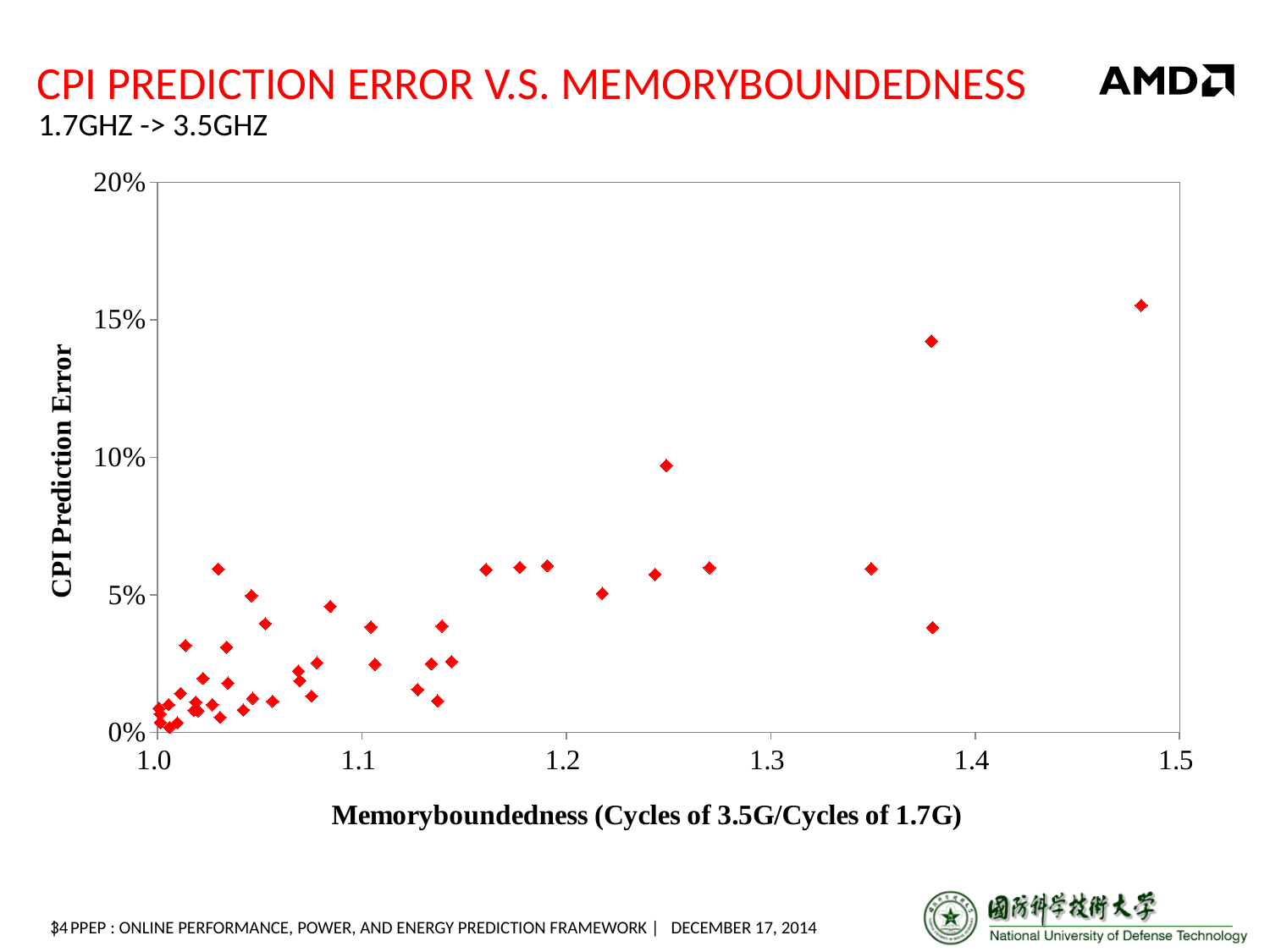
What kind of chart is shown on the slide? scatter chart What range does the y axis cover? 0% to 20% Are the points with memoryboundedness below 1.1 all greater or less than 10% CPI prediction error? less Is the CPI prediction error of the highest point near memoryboundedness 1.38 greater or less than 10%? greater As memoryboundedness increases along the x axis, does the CPI prediction error generally rise or fall? rise Which has the higher CPI prediction error: the rightmost point (near memoryboundedness 1.48) or the highest point near memoryboundedness 1.25? the rightmost point (near 1.48) Is the highest CPI prediction error plotted on the chart greater or less than 20%? less What is the title of the x axis? Memoryboundedness (Cycles of 3.5G/Cycles of 1.7G)